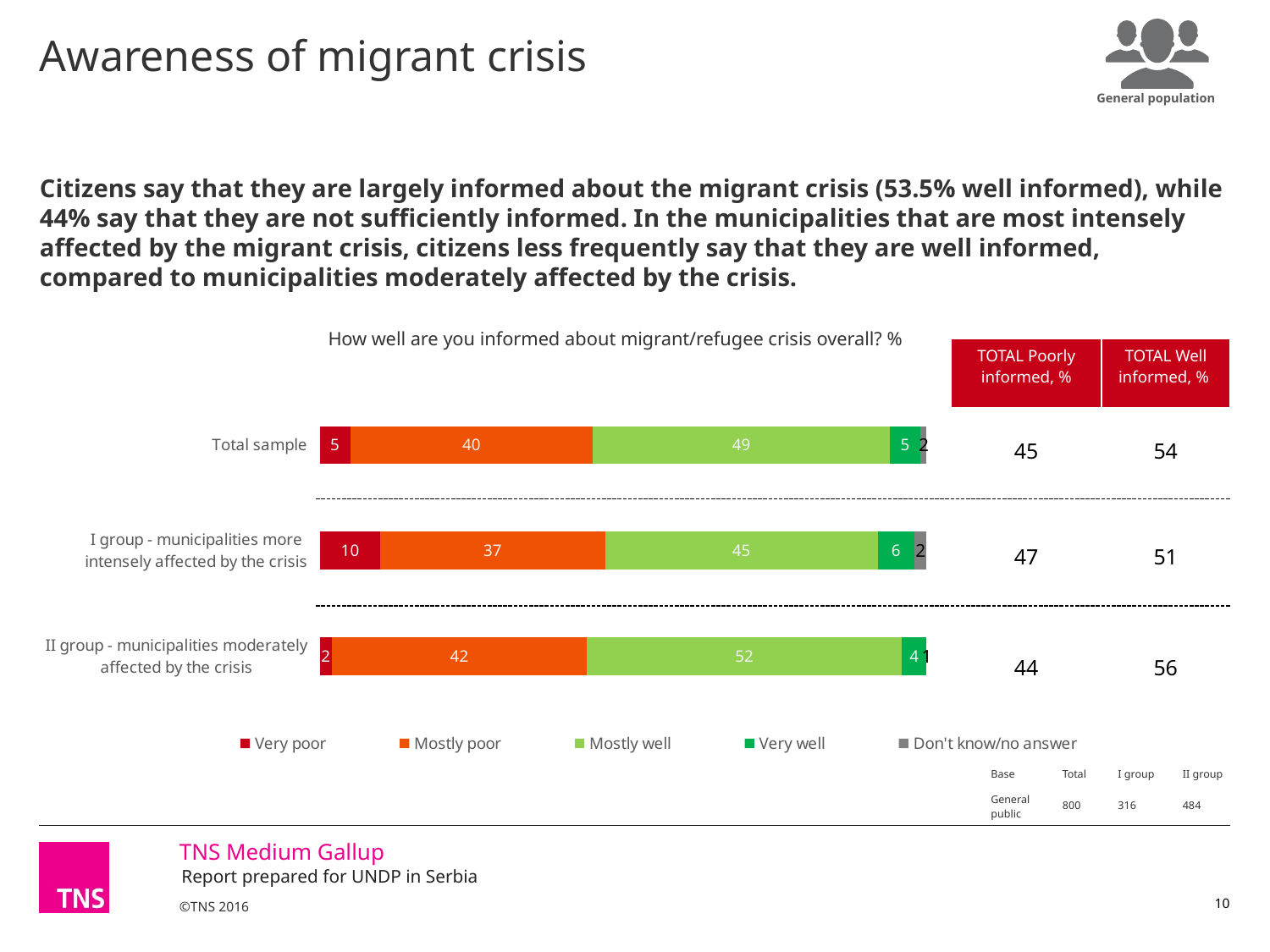
Which group has the highest 'Mostly well' value? II group - municipalities moderately affected by the crisis What kind of chart is shown on the slide? Stacked bar chart What is the 'Very poor' value for the I group - municipalities more intensely affected by the crisis? 10 What is the 'Don't know/no answer' value for the Total sample? 2 Is the 'Very well' value larger for the I group or the II group? I group What is the title of the chart? How well are you informed about migrant/refugee crisis overall? % How many categories (groups) are plotted in the chart? 3 What is the 'Mostly poor' value for the II group - municipalities moderately affected by the crisis? 42 How many series does the chart legend list? 5 Which group has the lowest 'Very poor' value? II group - municipalities moderately affected by the crisis What is the difference between the 'Mostly well' values of the II group and the I group? 7 What is the 'Mostly well' value for the Total sample? 49